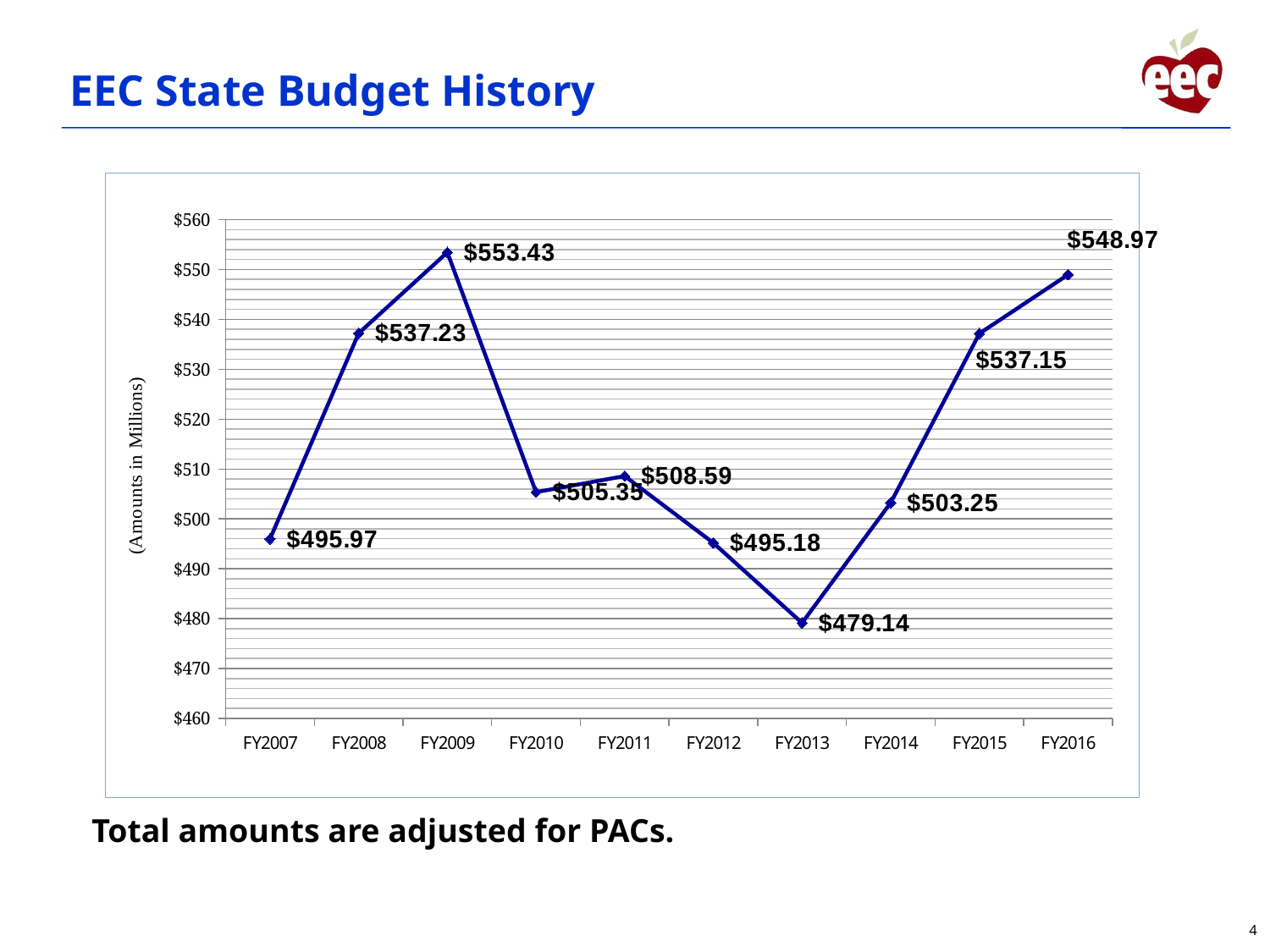
Do the values rise or fall from FY2013 to FY2016? rise What is the value for FY2013? $479.14 Which fiscal year has the highest value? FY2009 What is the difference between the values for FY2009 and FY2013? $74.29 How many fiscal years are plotted on the chart? 10 What kind of chart is shown on the slide? line chart What is the value for FY2009? $553.43 Which fiscal year has the lowest value? FY2013 What is the label on the vertical axis of the chart? (Amounts in Millions) What is the value for FY2016? $548.97 Which is larger, the value for FY2008 or the value for FY2015? FY2008 Is the value for FY2014 greater or less than $500? greater